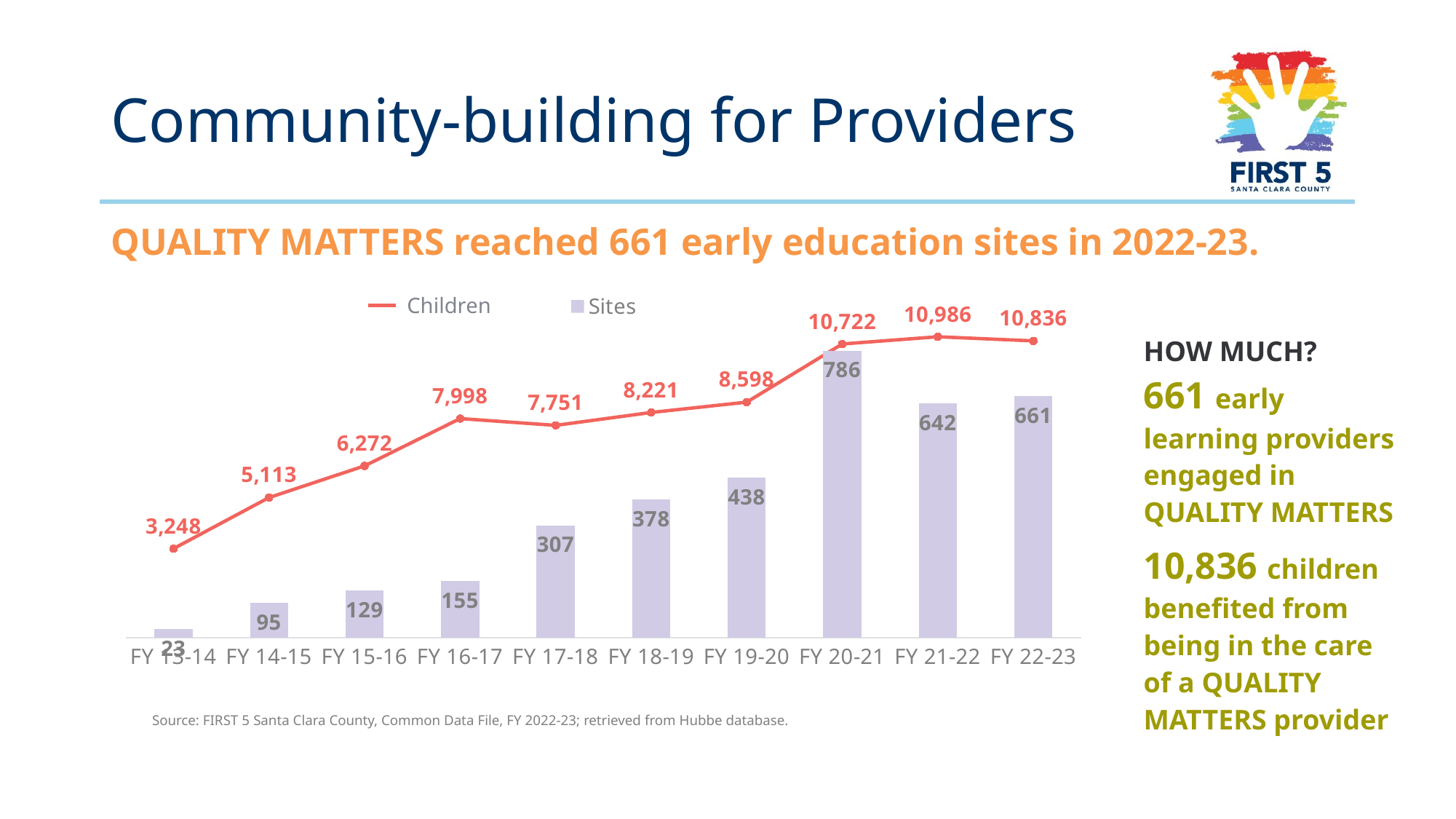
Which fiscal year has the highest number of sites? FY 20-21 How many children are shown for FY 16-17? 7,998 Do the number of sites generally rise or fall from FY 13-14 to FY 20-21? Rise Which fiscal year has more children, FY 21-22 or FY 22-23? FY 21-22 How many fiscal years are shown on the x axis? 10 How many series does the legend list? 2 What is the difference in the number of sites between FY 20-21 and FY 21-22? 144 How many sites are shown for FY 19-20? 438 Which fiscal year has the lowest number of children? FY 13-14 Which series is shown as a red line in the legend? Children What kind of chart is used to show the Sites series? Bar chart What is the difference in the number of children between FY 14-15 and FY 13-14? 1,865